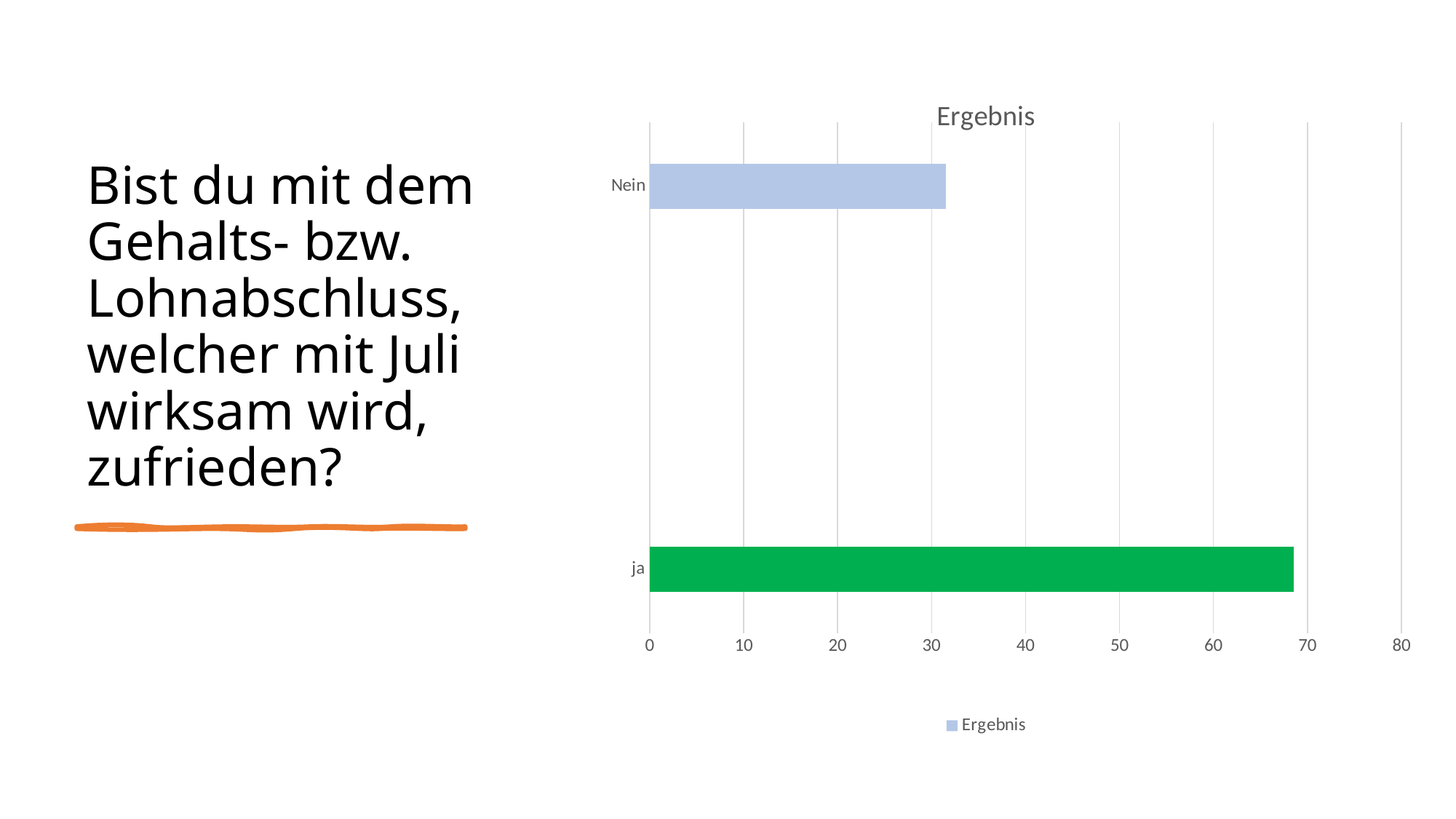
Which is larger, the value for ja or the value for Nein? ja Is the value for Nein greater or less than 20? greater How many series does the legend list? 1 Is the value for ja greater or less than 60? greater Is the value for Nein greater or less than 40? less What is the title of the chart? Ergebnis What kind of chart is shown on the slide? bar chart What is the highest value shown on the x axis? 80 Which category has the lowest value? Nein What is the name of the series listed in the legend? Ergebnis Which category has the highest value? ja How many categories does the chart show? 2